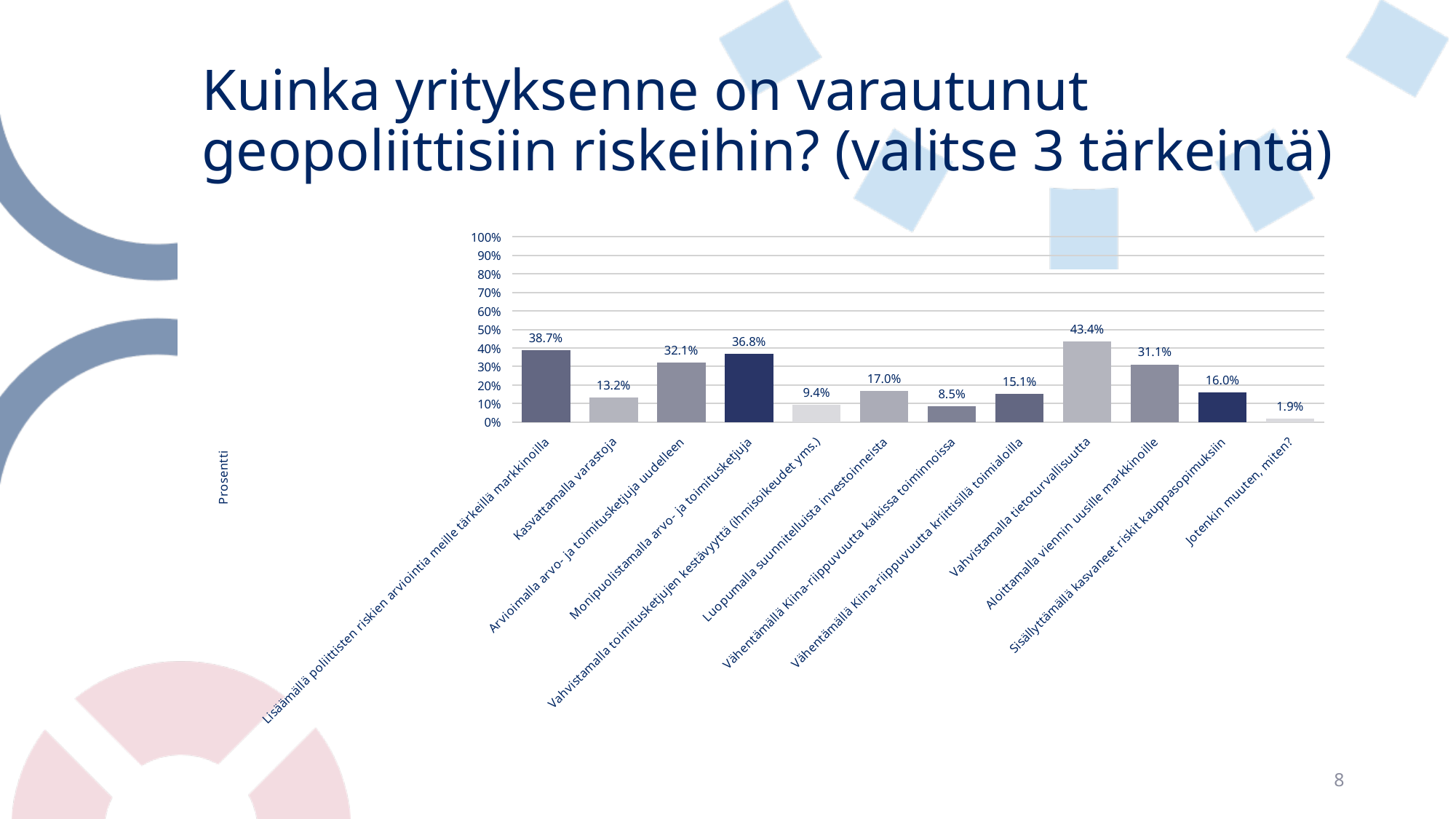
What is the value for "Kasvattamalla varastoja"? 13.2% How many categories are shown in the chart? 12 What kind of chart is shown on the slide? bar chart Which is larger: the value for "Luopumalla suunnitelluista investoinneista" or the value for "Sisällyttämällä kasvaneet riskit kauppasopimuksiin"? Luopumalla suunnitelluista investoinneista What is the value for "Vahvistamalla tietoturvallisuutta"? 43.4% What is the value for "Vähentämällä Kiina-riippuvuutta kaikissa toiminnoissa"? 8.5% What is the value for "Aloittamalla viennin uusille markkinoille"? 31.1% Which category has the lowest value? Jotenkin muuten, miten? Is the value for "Monipuolistamalla arvo- ja toimitusketjuja" greater or less than 30%? greater Which category has the highest value? Vahvistamalla tietoturvallisuutta What is the label of the vertical axis? Prosentti What is the difference between the values for "Vahvistamalla tietoturvallisuutta" and "Lisäämällä poliittisten riskien arviointia meille tärkeillä markkinoilla"? 4.7%